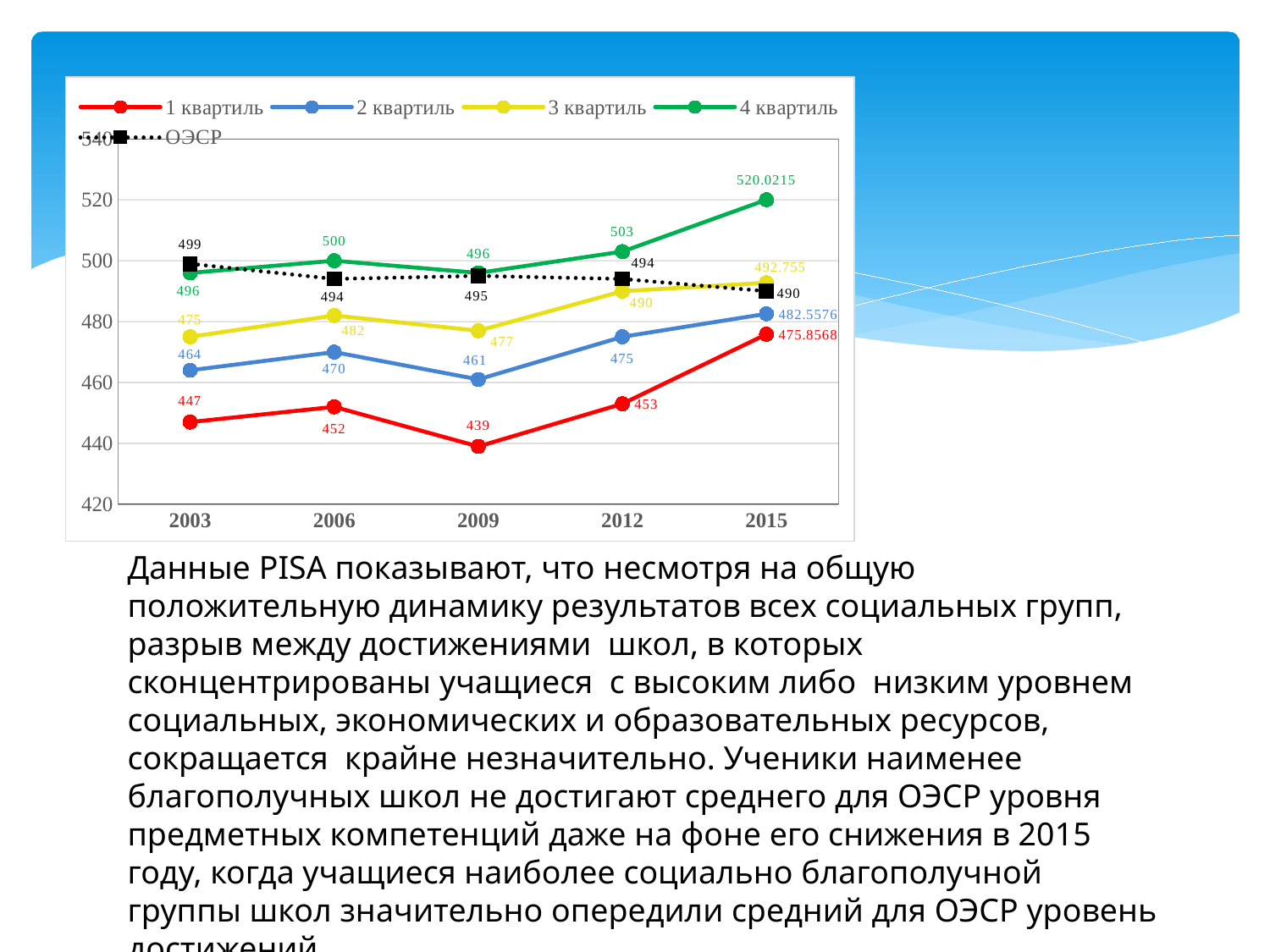
What is the value for ОЭСР in 2003? 499 Does the ОЭСР series rise or fall from 2003 to 2015? fall In which year is the value for 2 квартиль lowest? 2009 What kind of chart is shown on the slide? line chart What is the value for 4 квартиль in 2015? 520.0215 What is the difference between the 4 квартиль and 1 квартиль values in 2003? 49 How many years are shown on the x axis? 5 Which is larger in 2015: the value for 3 квартиль or the value for ОЭСР? 3 квартиль How many series does the legend list? 5 What is the value for 1 квартиль in 2009? 439 In which year is the value for 4 квартиль highest? 2015 What is the value for 3 квартиль in 2012? 490